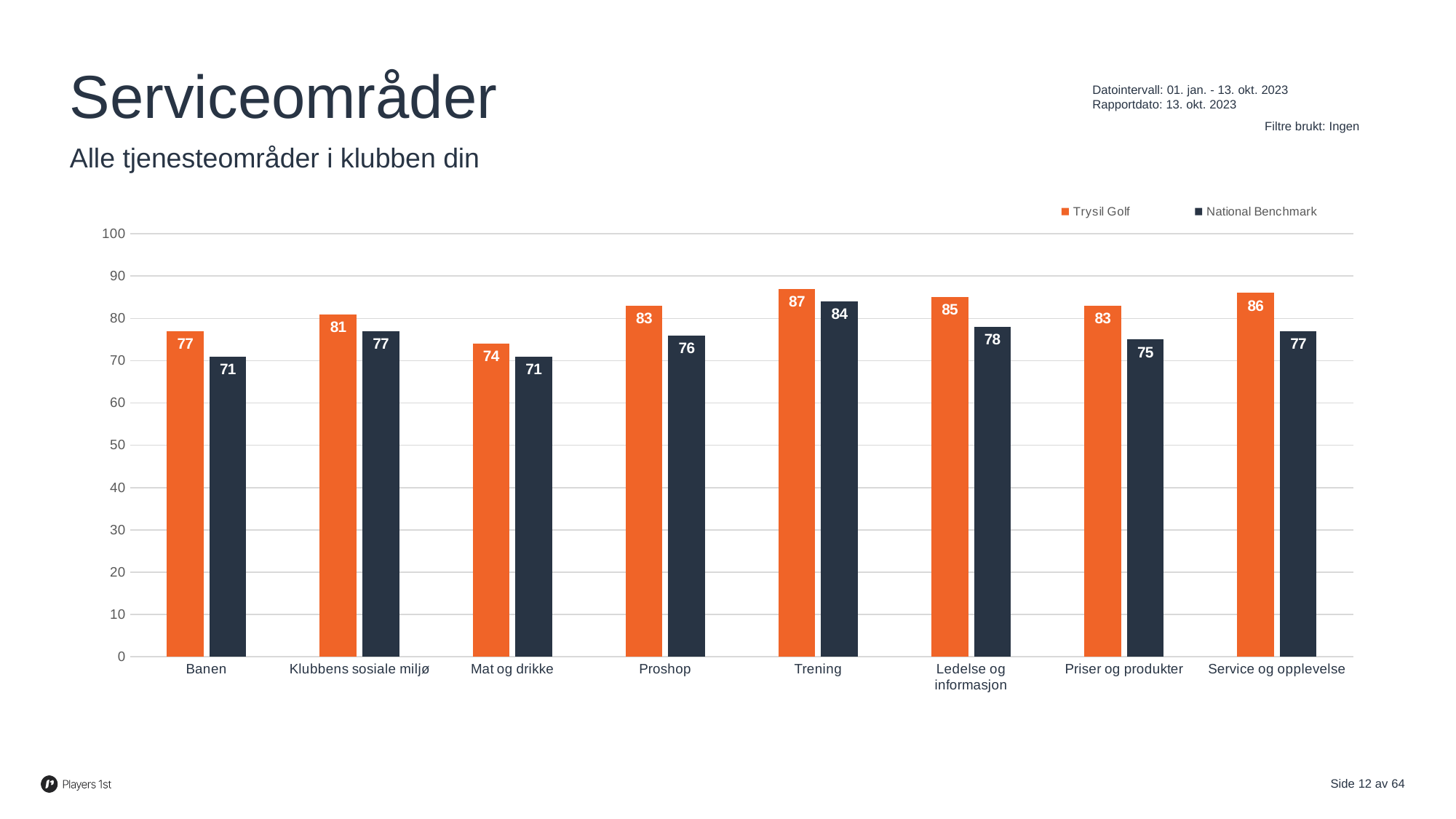
What is the difference between the Trysil Golf and National Benchmark values for Priser og produkter? 8 Is the National Benchmark value for Trening greater or less than 80? greater What is the National Benchmark value for Ledelse og informasjon? 78 Which category has the highest Trysil Golf value? Trening Which colour represents National Benchmark in the chart? dark navy How many categories are shown on the x axis? 8 What is the Trysil Golf value for Proshop? 83 Which category has the lowest Trysil Golf value? Mat og drikke What is the Trysil Golf value for Mat og drikke? 74 How many series does the legend list? 2 Which is larger for Banen: the Trysil Golf value or the National Benchmark value? Trysil Golf What kind of chart is shown on the slide? bar chart